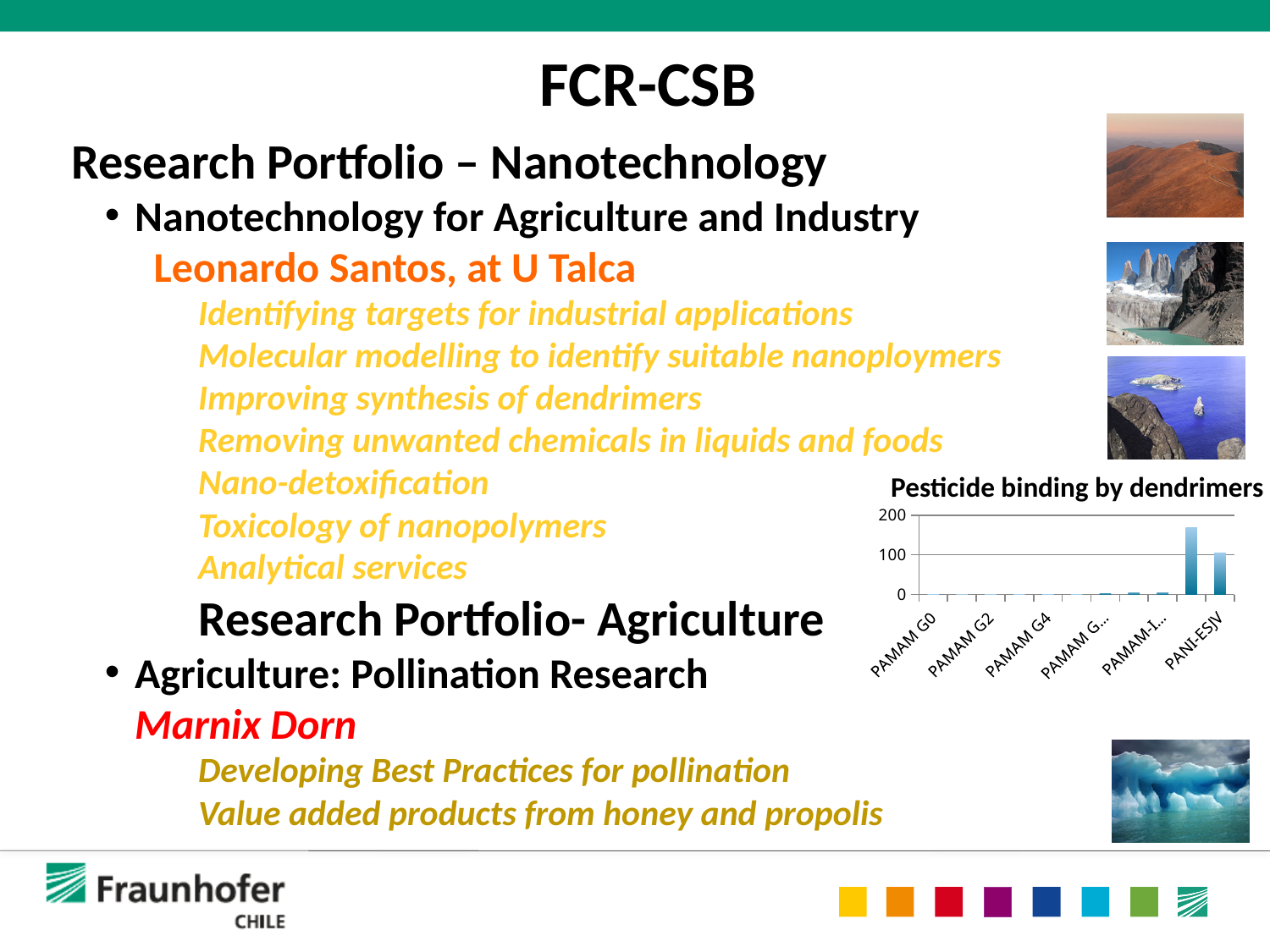
In the 'Pesticide binding by dendrimers' chart, do the bar values generally rise or fall from left to right along the x axis? rise In the 'Pesticide binding by dendrimers' chart, is the value for PAMAM G4 greater or less than 100? less What is the title of the chart on the slide? Pesticide binding by dendrimers In the 'Pesticide binding by dendrimers' chart, is the tallest bar greater or less than 200? less In the 'Pesticide binding by dendrimers' chart, is the value for PAMAM G0 greater or less than 100? less What is the highest value shown on the y-axis of the 'Pesticide binding by dendrimers' chart? 200 What type of chart is shown under the title 'Pesticide binding by dendrimers'? bar chart In the 'Pesticide binding by dendrimers' chart, which is larger: the value for PAMAM G0 or the tallest bar at the right end of the chart? the tallest bar at the right end